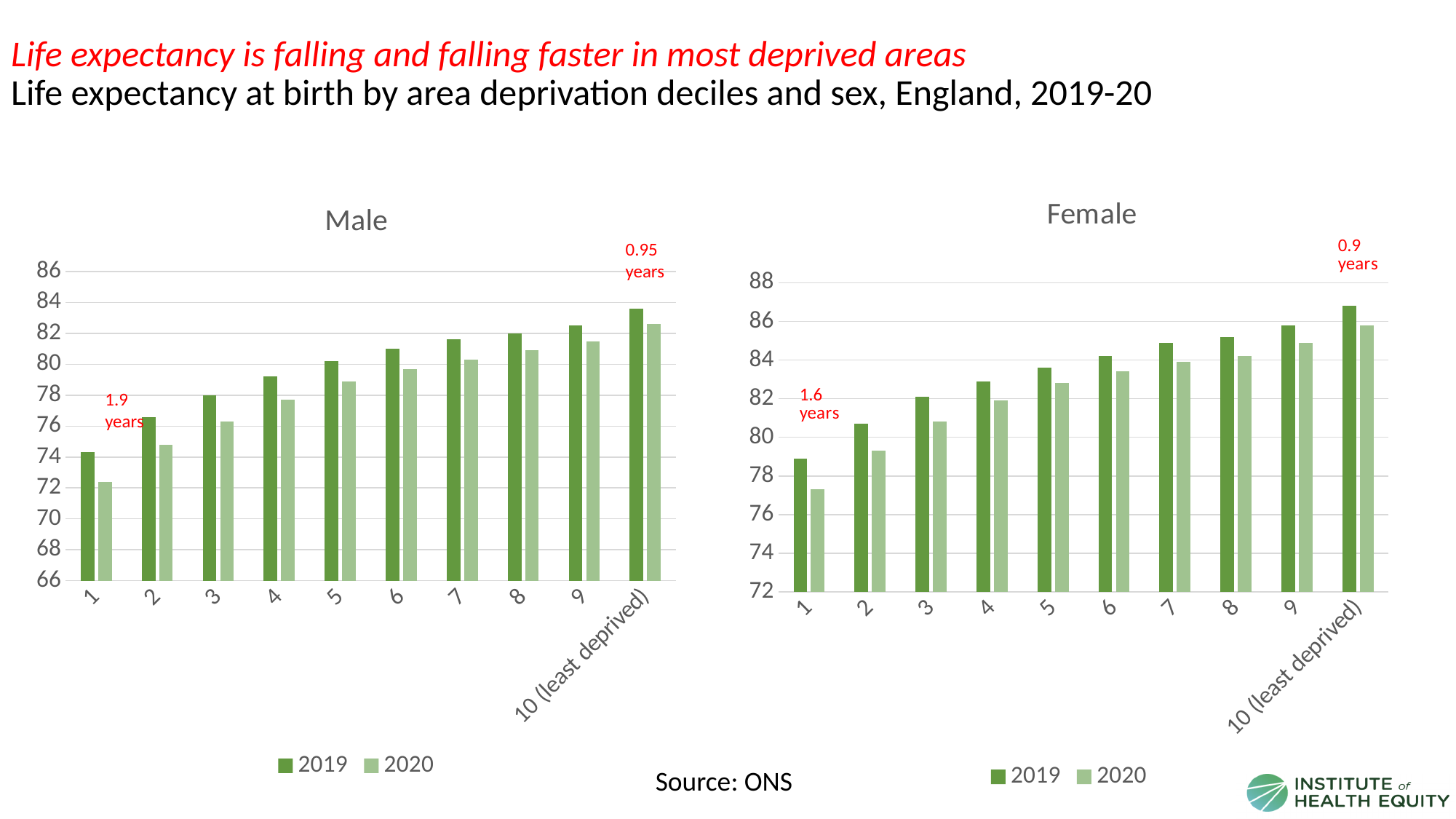
In the Female chart, is the 2020 value for decile 1 greater or less than 78? less How many deprivation deciles are shown on the x axis of the Female chart? 10 In the Male chart, what drop in life expectancy is annotated for decile 1? 1.9 years In the Female chart, which decile has the lowest 2020 life expectancy? 1 In the Female chart, what drop in life expectancy is annotated for decile 10 (least deprived)? 0.9 years How many series does the legend of the Male chart list? 2 What kind of chart is the Male chart? bar chart In the Male chart, which is larger for decile 1: the 2019 value or the 2020 value? 2019 In the Male chart, is the 2020 value for decile 1 greater or less than 74? less In the Male chart, which decile has the highest 2019 life expectancy? 10 (least deprived) In the Male chart, do the 2019 values rise or fall as the deciles go from 1 to 10? rise In the Female chart, is the 2019 value for decile 10 (least deprived) greater or less than 86? greater